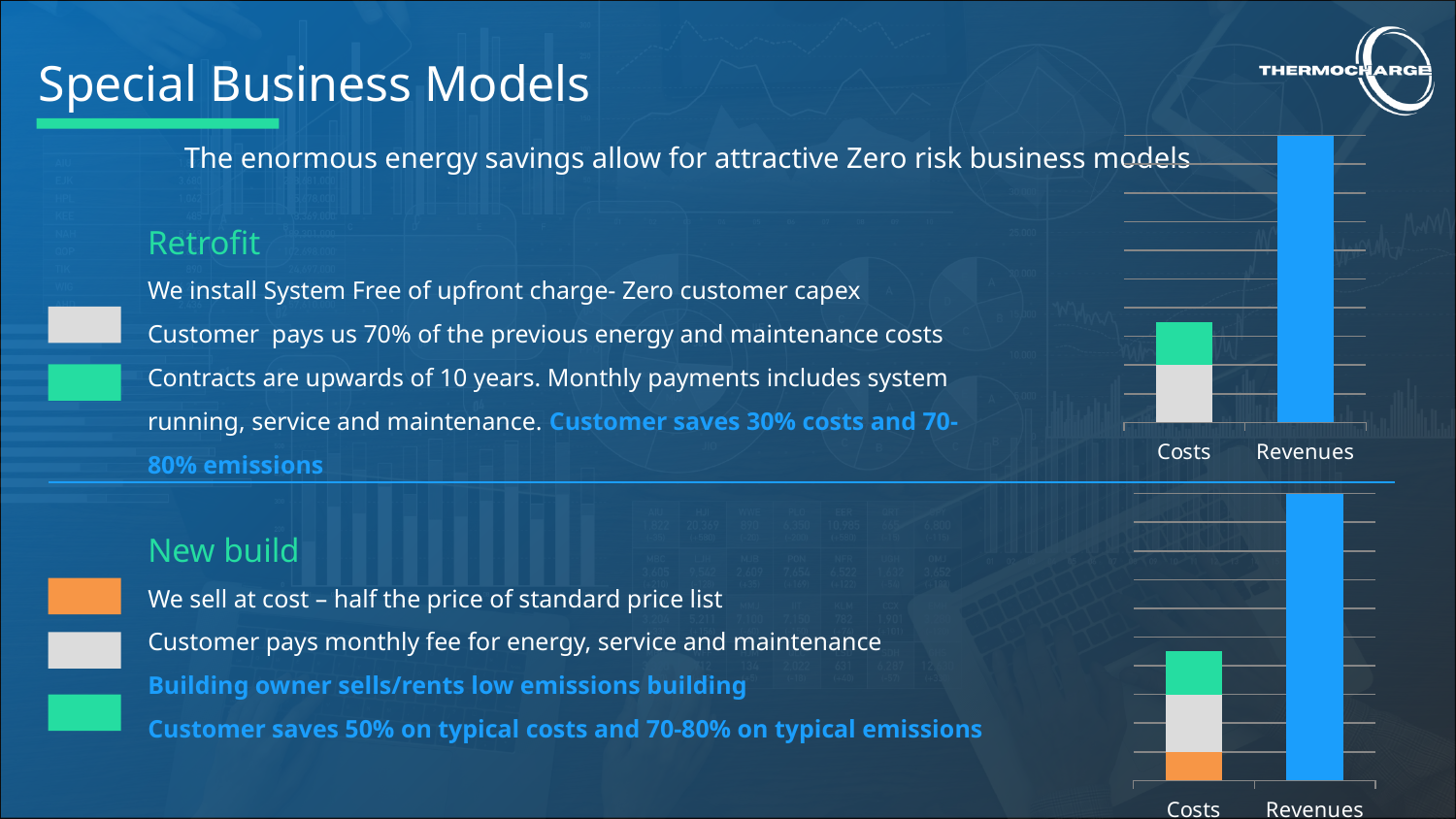
What are the two category labels on the x axis of the top chart (Retrofit)? Costs and Revenues In the bottom chart (New build), which bar is taller, Costs or Revenues? Revenues In the top chart (Retrofit), which category has the highest bar? Revenues In the bottom chart (New build), how many coloured segments make up the Costs bar? 3 In the top chart (Retrofit), how many coloured segments make up the Costs bar? 2 In the bottom chart (New build), how many categories are shown on the x axis? 2 What kind of chart is the bottom chart next to the New build section? Stacked bar chart In the top chart (Retrofit), how many categories are shown on the x axis? 2 In the top chart (Retrofit), which bar is taller, Costs or Revenues? Revenues In the bottom chart (New build), which category has the lowest bar? Costs What kind of chart is the top chart next to the Retrofit section? Stacked bar chart